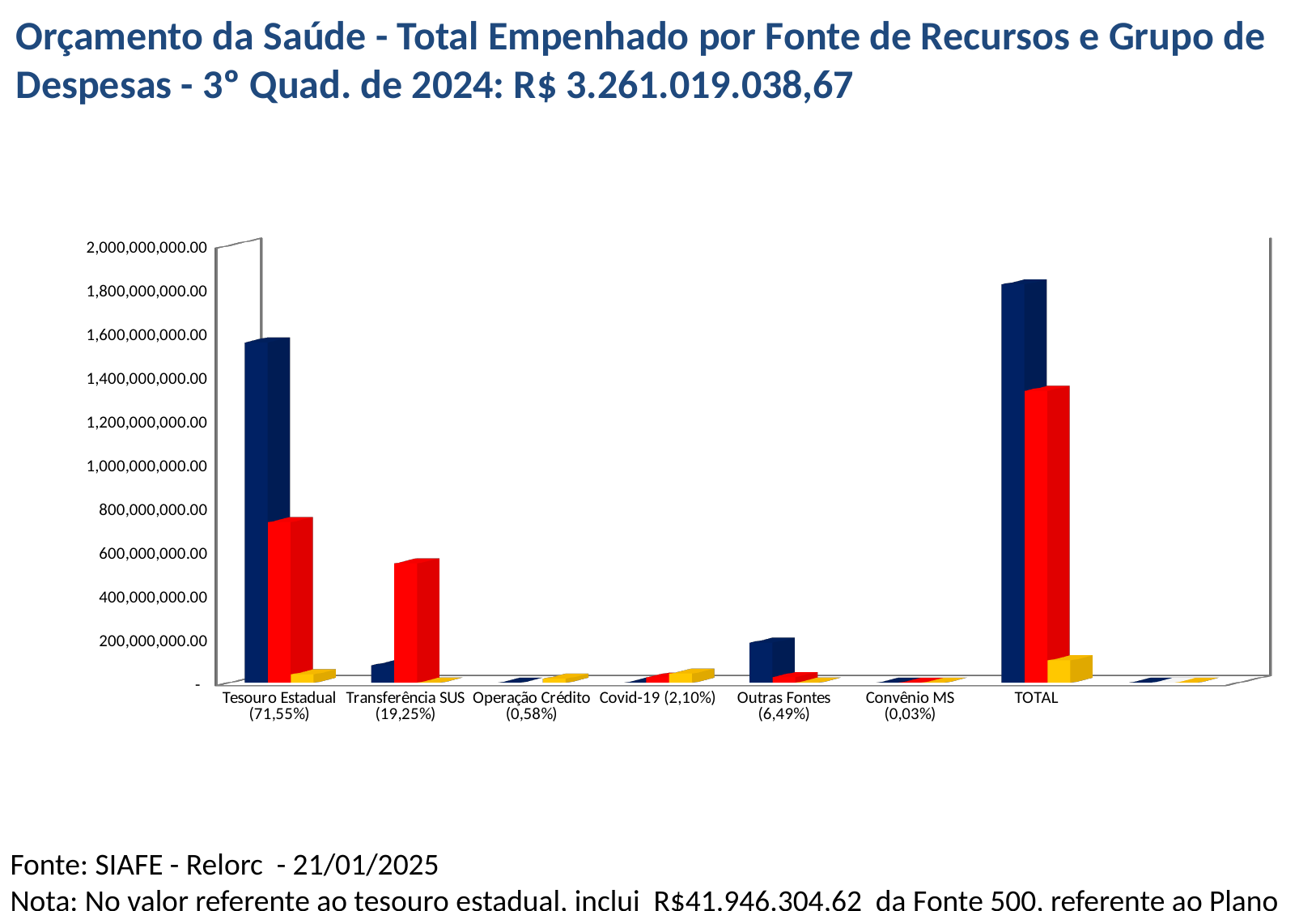
Is the value of the dark blue bar for Tesouro Estadual greater or less than 1,400,000,000.00? greater Is the value of the red bar for Tesouro Estadual greater or less than 800,000,000.00? less For Transferência SUS, which bar is taller: the dark blue bar or the red bar? the red bar What percentage is shown in the category label for Tesouro Estadual? 71,55% What percentage is shown in the category label for Outras Fontes? 6,49% Is the value of the dark blue bar for Outras Fontes greater or less than 400,000,000.00? less What kind of chart is shown on the slide? bar chart How many categories are shown along the x axis of the chart? 7 For Tesouro Estadual, which bar is taller: the dark blue bar or the red bar? the dark blue bar What percentage is shown in the category label for Convênio MS? 0,03% What total amount is stated in the chart title for the 3º Quad. de 2024? R$ 3.261.019.038,67